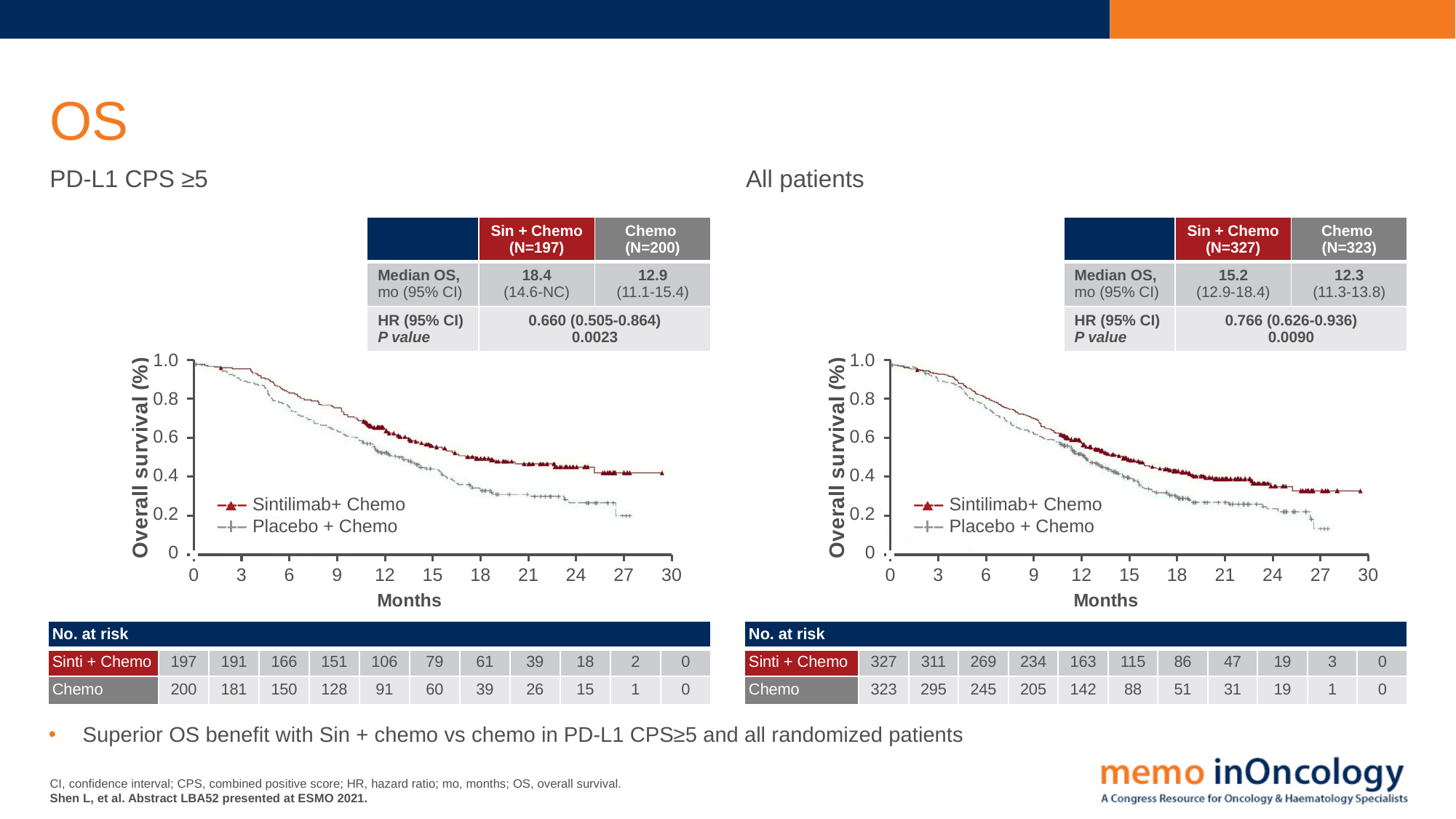
In the 'All patients' chart, how many Sinti + Chemo patients were at risk at 12 months? 163 In the 'PD-L1 CPS ≥5' chart, what is the median OS for Sin + Chemo? 18.4 In the 'All patients' chart, how many series does the legend list? 2 What kind of chart is shown under the 'PD-L1 CPS ≥5' heading? Line chart (Kaplan-Meier survival curve) In the 'PD-L1 CPS ≥5' chart, is the Placebo + Chemo curve at 24 months greater or less than 0.4? less In the 'All patients' chart, which curve is higher at 24 months, Sintilimab + Chemo or Placebo + Chemo? Sintilimab + Chemo In the 'PD-L1 CPS ≥5' chart, do the survival curves rise or fall as months increase? Fall In the 'PD-L1 CPS ≥5' chart, is the Sintilimab + Chemo curve at 24 months greater or less than 0.4? greater In the 'PD-L1 CPS ≥5' chart, what colour is the Sintilimab + Chemo curve? Red In the 'PD-L1 CPS ≥5' chart, what is the difference in median OS between Sin + Chemo and Chemo? 5.5 In the 'All patients' chart, what is the HR (95% CI)? 0.766 (0.626-0.936)